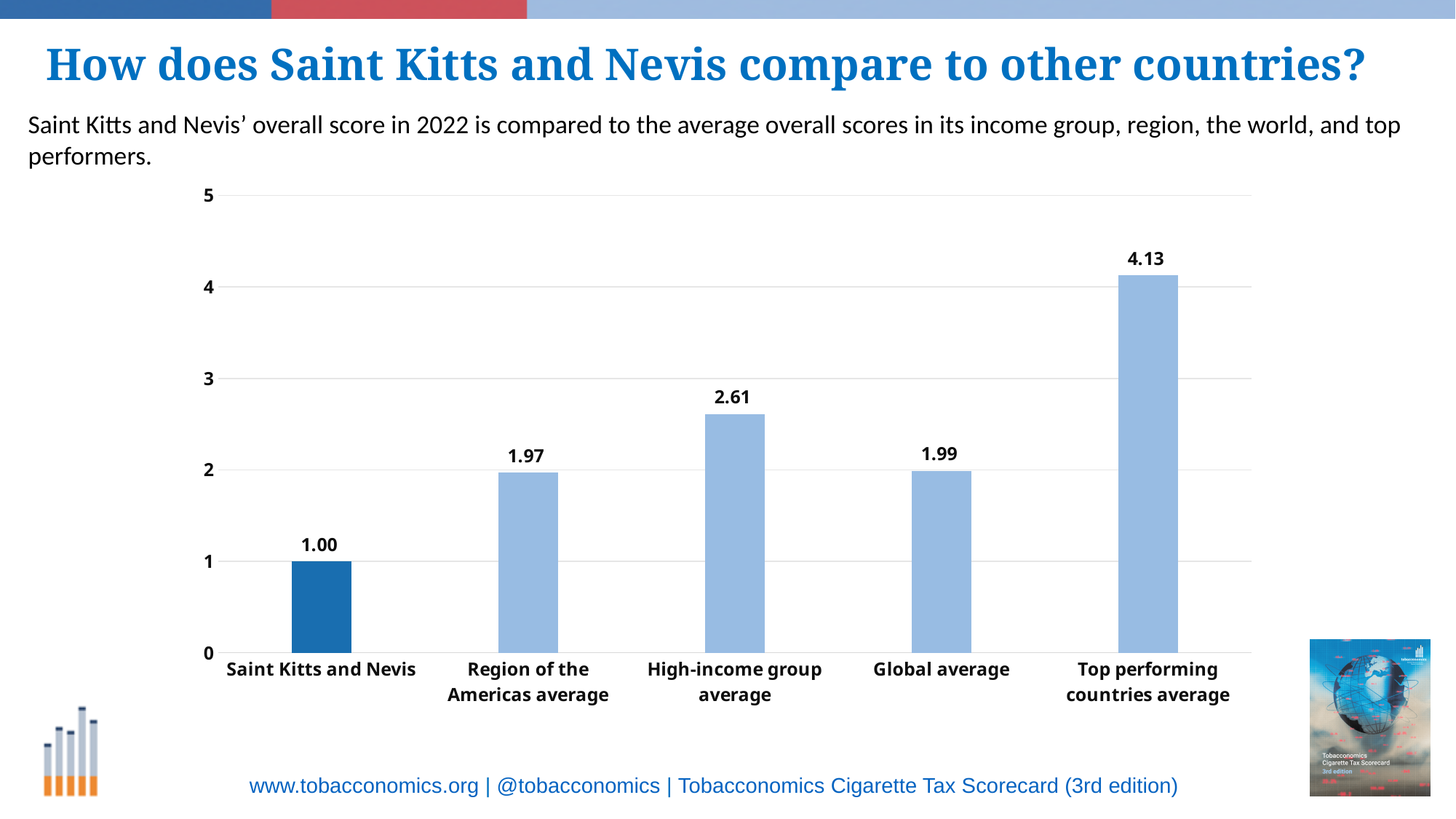
Which is larger, the High-income group average or the Global average? High-income group average What is the difference between the Top performing countries average and Saint Kitts and Nevis? 3.13 What kind of chart is shown on the slide? bar chart What is the value for the Top performing countries average? 4.13 Is the value for the Region of the Americas average greater or less than 3? less What is the value for the Global average? 1.99 What is the value for the High-income group average? 2.61 What is the value for Saint Kitts and Nevis? 1.00 Which bar is shown in a darker blue than the others? Saint Kitts and Nevis Which category has the lowest value? Saint Kitts and Nevis How many categories are shown in the chart? 5 Which category has the highest value? Top performing countries average